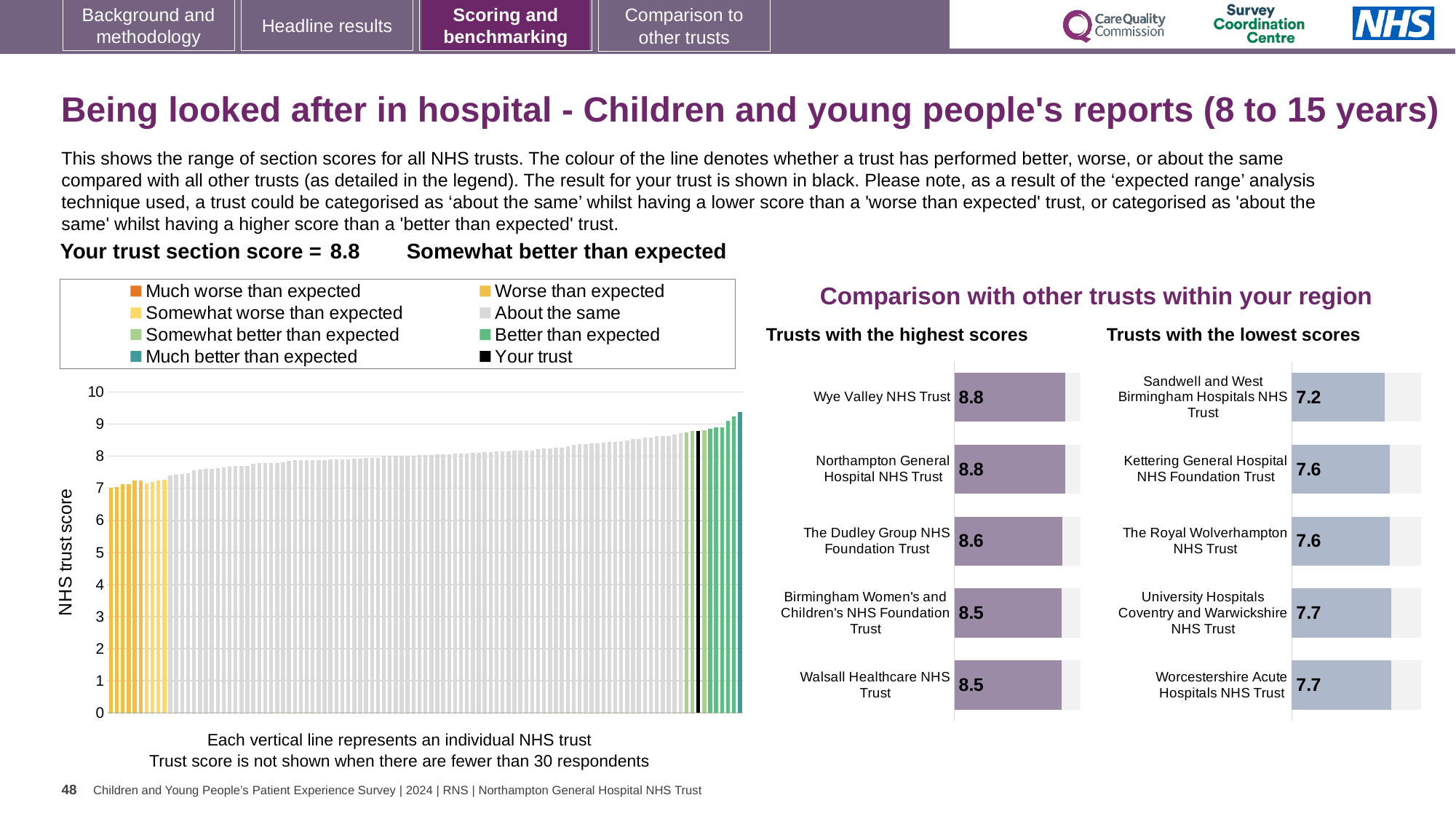
What kind of chart is the large chart on the left showing NHS trust scores? Bar chart In the 'Trusts with the lowest scores' chart, what is the score for Sandwell and West Birmingham Hospitals NHS Trust? 7.2 What is the y-axis label of the large chart on the left? NHS trust score In the 'Trusts with the highest scores' chart, what is the difference between the score for Wye Valley NHS Trust and the score for The Dudley Group NHS Foundation Trust? 0.2 In the large chart on the left, do the trust scores rise or fall from left to right? Rise In the 'Trusts with the lowest scores' chart, what is the difference between the score for Worcestershire Acute Hospitals NHS Trust and the score for Sandwell and West Birmingham Hospitals NHS Trust? 0.5 How many trusts are listed in the 'Trusts with the lowest scores' chart? 5 In the 'Trusts with the lowest scores' chart, what is the score for Kettering General Hospital NHS Foundation Trust? 7.6 In the 'Trusts with the highest scores' chart, which has the higher score: The Dudley Group NHS Foundation Trust or Walsall Healthcare NHS Trust? The Dudley Group NHS Foundation Trust In the 'Trusts with the highest scores' chart, what is the score for The Dudley Group NHS Foundation Trust? 8.6 In the large chart on the left, is the value of the tallest bar greater or less than 9? greater In the 'Trusts with the lowest scores' chart, which trust has the lowest score? Sandwell and West Birmingham Hospitals NHS Trust